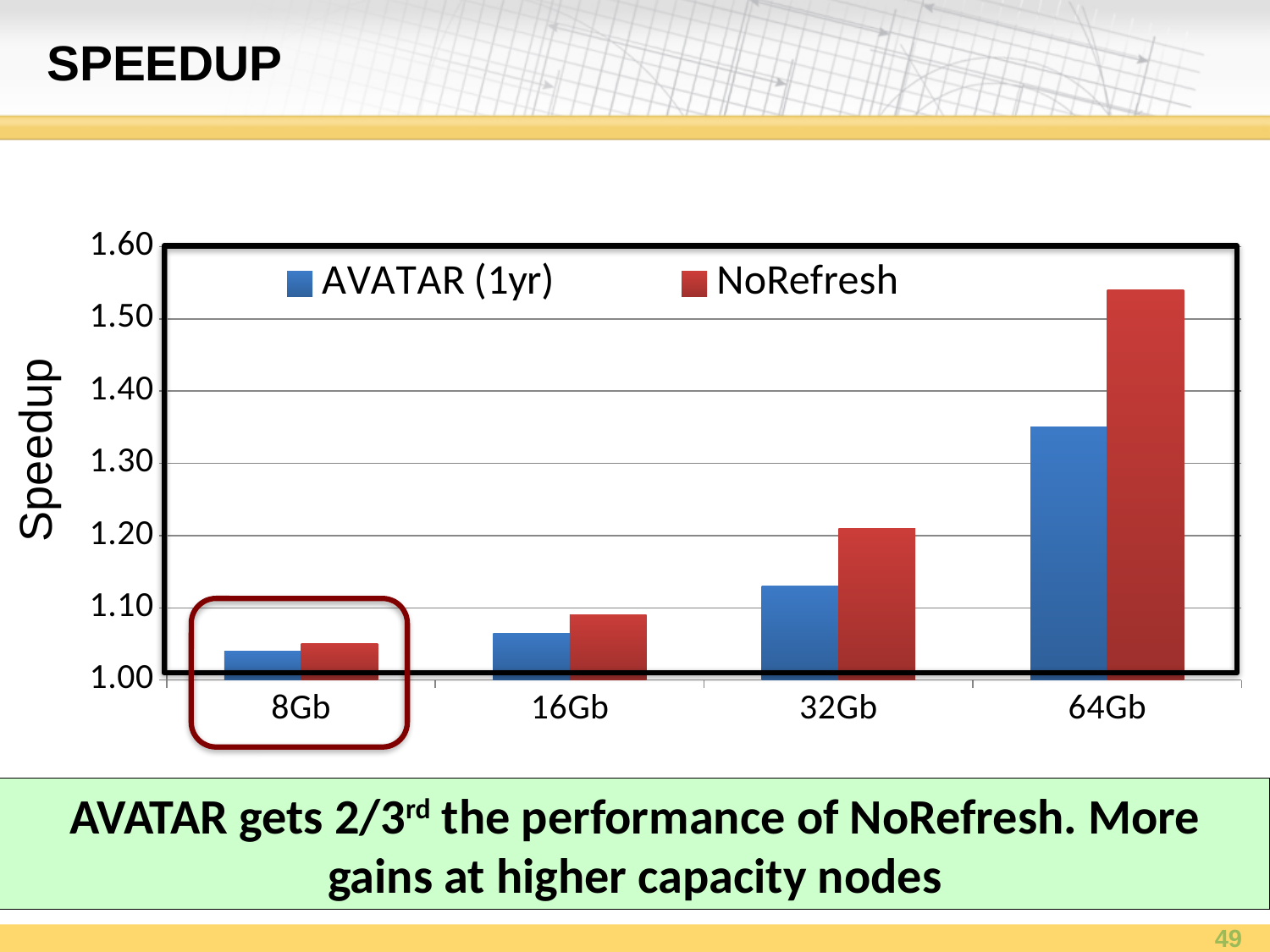
Is the AVATAR (1yr) speedup at 64Gb greater or less than 1.40? less What kind of chart is shown on the slide? bar chart How many series does the legend list? 2 Which series and category has the highest speedup? NoRefresh at 64Gb Is the NoRefresh speedup at 64Gb greater or less than 1.50? greater At which capacity is the AVATAR (1yr) speedup highest? 64Gb At 32Gb, which series has the larger speedup, AVATAR (1yr) or NoRefresh? NoRefresh How many capacity categories are shown on the x axis? 4 Does the speedup for NoRefresh rise or fall as capacity increases from 8Gb to 64Gb? rise At 64Gb, which series has the larger speedup, AVATAR (1yr) or NoRefresh? NoRefresh Is the AVATAR (1yr) speedup at 32Gb greater or less than 1.10? greater At which capacity is the NoRefresh speedup lowest? 8Gb